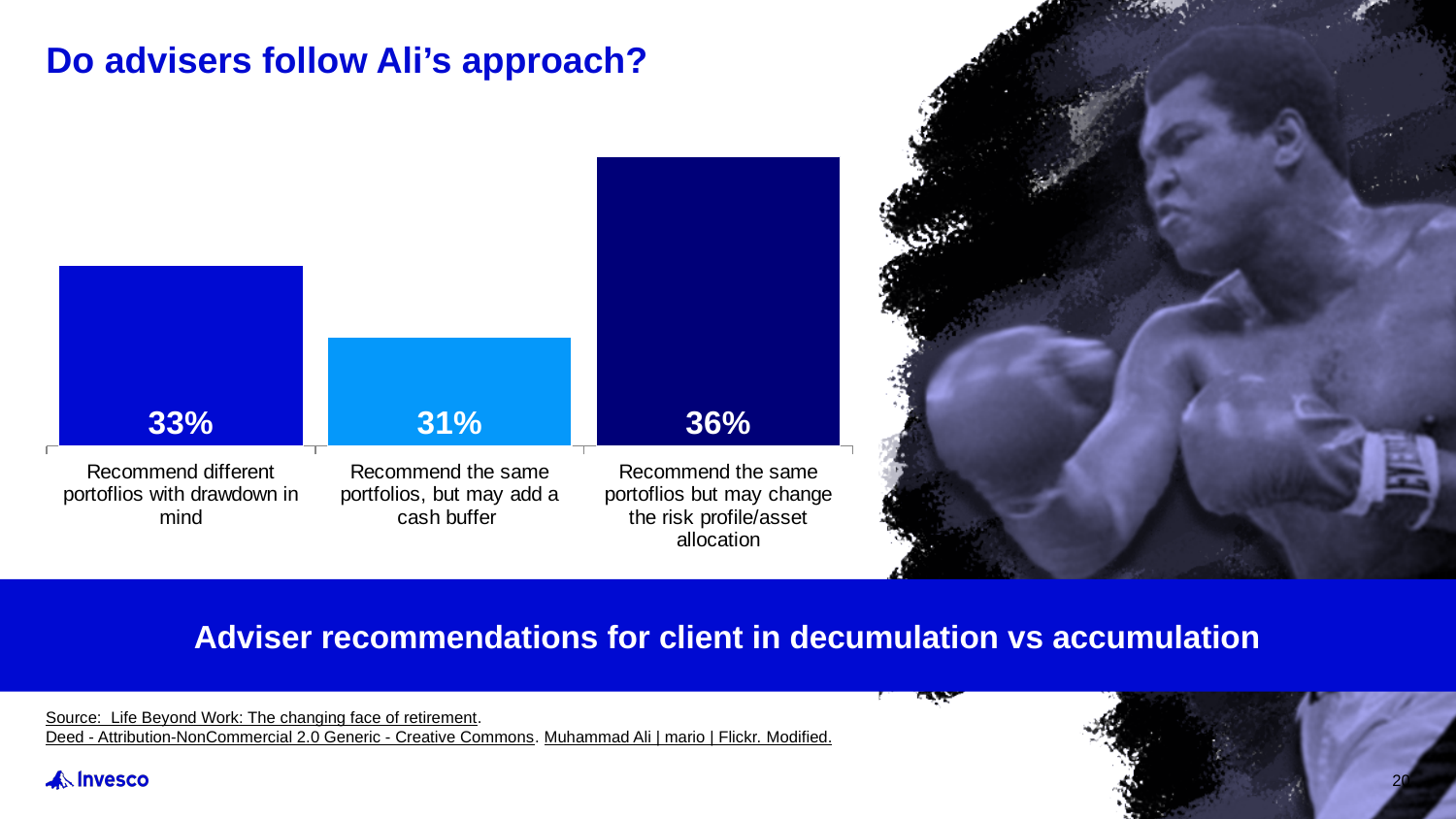
What is the caption shown below the chart? Adviser recommendations for client in decumulation vs accumulation Which is larger: the percentage recommending different portfolios with drawdown in mind or the percentage recommending the same portfolios but may add a cash buffer? Recommend different portfolios with drawdown in mind What is the difference in percentage points between advisers who recommend the same portfolios but may change the risk profile/asset allocation and those who recommend the same portfolios but may add a cash buffer? 5 percentage points What is the difference in percentage points between advisers who recommend different portfolios with drawdown in mind and those who recommend the same portfolios but may add a cash buffer? 2 percentage points What percentage of advisers recommend different portfolios with drawdown in mind? 33% What percentage of advisers recommend the same portfolios but may change the risk profile/asset allocation? 36% What is the title of the slide containing the chart? Do advisers follow Ali's approach? What type of chart is used to show adviser recommendations? Bar chart Which adviser recommendation category has the highest percentage? Recommend the same portfolios but may change the risk profile/asset allocation What percentage of advisers recommend the same portfolios but may add a cash buffer? 31% Which adviser recommendation category has the lowest percentage? Recommend the same portfolios, but may add a cash buffer How many adviser recommendation categories are shown in the chart? 3